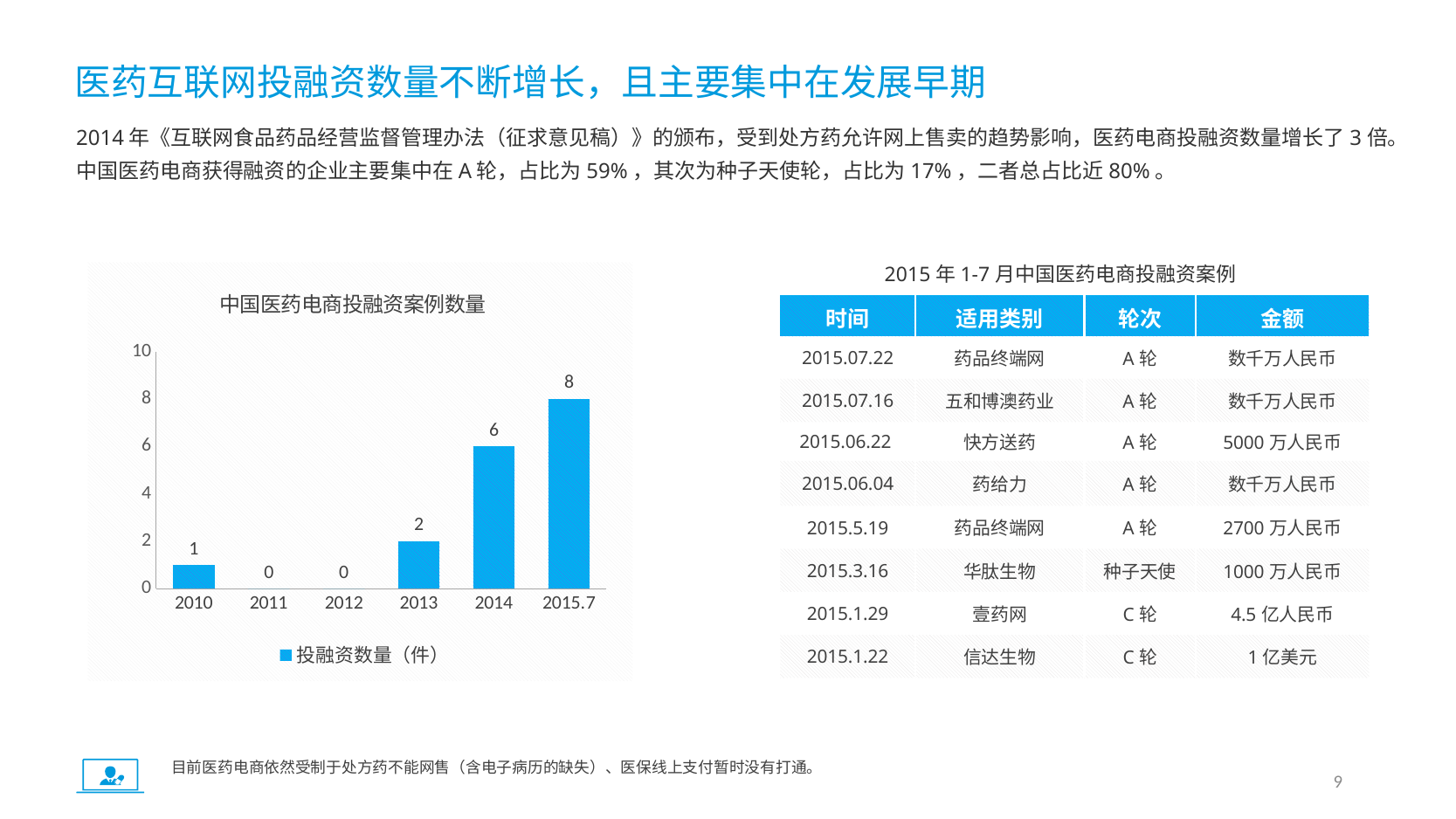
What is the legend entry of the chart 中国医药电商投融资案例数量? 投融资数量（件） How many series does the legend of the chart 中国医药电商投融资案例数量 list? 1 What is the difference between the values for 2014 and 2013 in the chart 中国医药电商投融资案例数量? 4 Do the values in the chart 中国医药电商投融资案例数量 generally rise or fall from 2012 to 2015.7? rise Which category has the highest value in the chart 中国医药电商投融资案例数量? 2015.7 What is the value for 2013 in the chart 中国医药电商投融资案例数量? 2 What is the value for 2010 in the chart 中国医药电商投融资案例数量? 1 What kind of chart is 中国医药电商投融资案例数量? bar chart What is the value for 2014 in the chart 中国医药电商投融资案例数量? 6 How many categories are shown on the x axis of the chart 中国医药电商投融资案例数量? 6 What is the value for 2015.7 in the chart 中国医药电商投融资案例数量? 8 Which is larger in the chart 中国医药电商投融资案例数量, the value for 2014 or the value for 2015.7? 2015.7